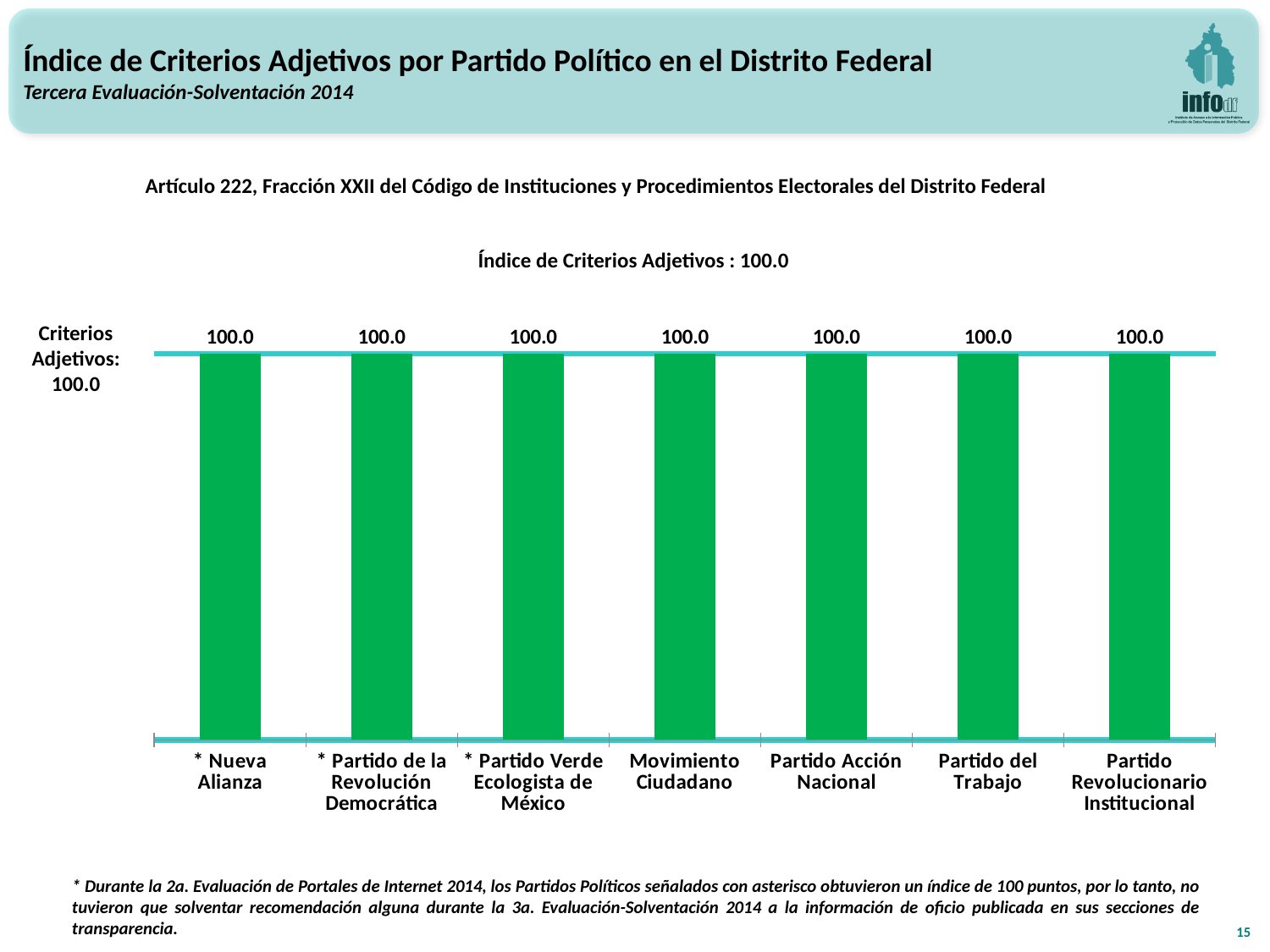
What is the value for * Nueva Alianza? 100.0 How many categories are marked with an asterisk in the chart? 3 How many political parties (categories) are shown in the chart? 7 What is the value for Partido del Trabajo? 100.0 What is the title of the chart? Índice de Criterios Adjetivos : 100.0 What is the value for Partido Revolucionario Institucional? 100.0 What is the value for Movimiento Ciudadano? 100.0 Do the values rise, fall, or stay the same across the categories from left to right? stay the same What is the value for Partido Acción Nacional? 100.0 What is the difference between the values for Partido del Trabajo and * Partido Verde Ecologista de México? 0.0 What colour are the bars in the chart? green What kind of chart is shown on the slide? bar chart